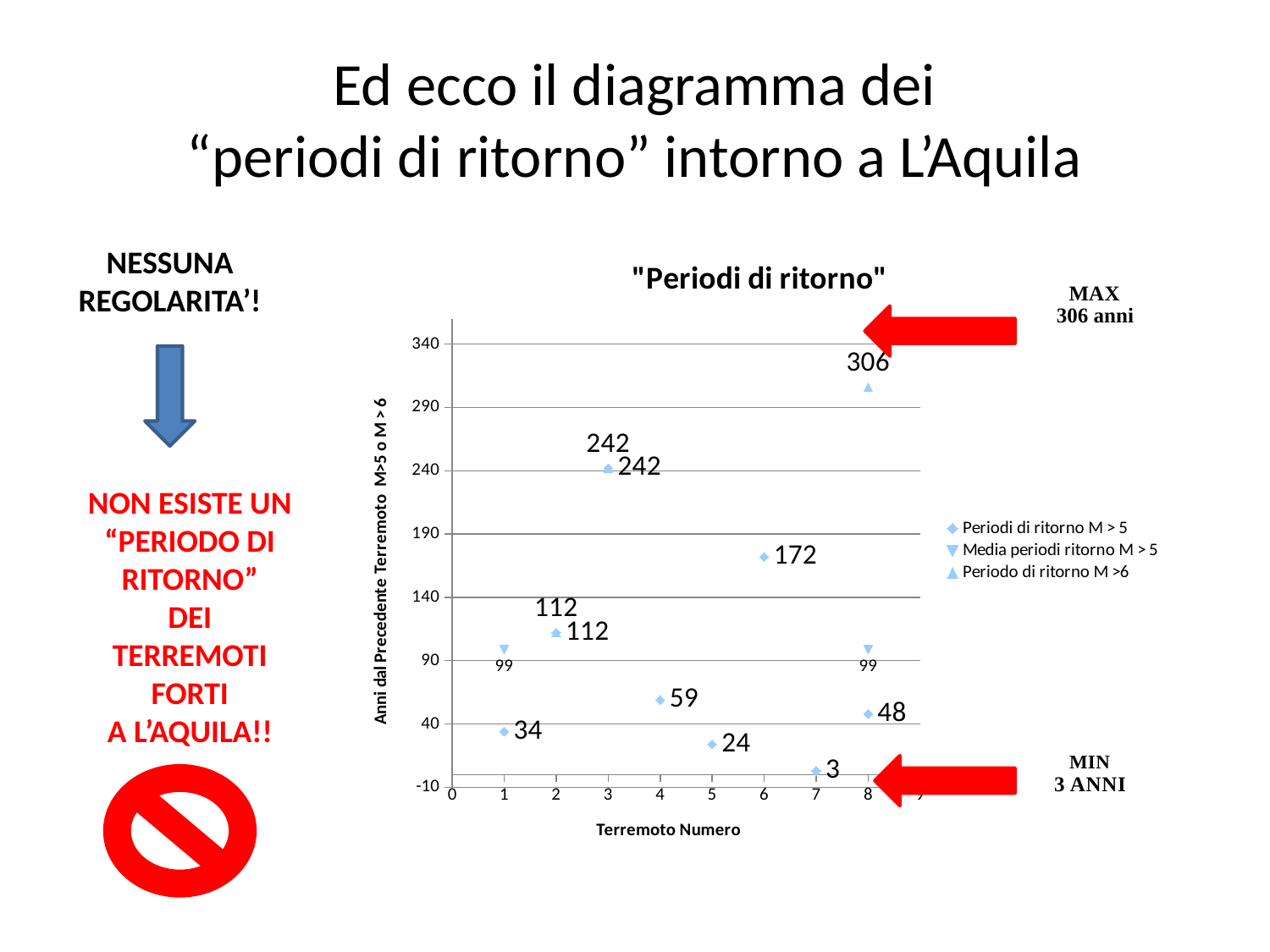
What is the value of the 'Media periodi ritorno M > 5' series for earthquake number 1? 99 How many series does the chart legend list? 3 What is the value of the 'Periodi di ritorno M > 5' series for earthquake number 5? 24 How many data points are plotted for the 'Periodi di ritorno M > 5' series? 8 What type of chart is shown on the slide? scatter chart What is the difference between the 'Periodi di ritorno M > 5' values for earthquake number 3 and earthquake number 1? 208 What is the title of the chart? "Periodi di ritorno" Which earthquake number has the lowest value in the 'Periodi di ritorno M > 5' series? 7 What is the value of the 'Periodi di ritorno M > 5' series for earthquake number 6? 172 Which is larger in the 'Periodi di ritorno M > 5' series: the value for earthquake number 4 or earthquake number 8? earthquake number 4 Which earthquake number has the highest value in the 'Periodi di ritorno M > 5' series? 3 What is the value of the 'Periodo di ritorno M >6' series for earthquake number 8? 306